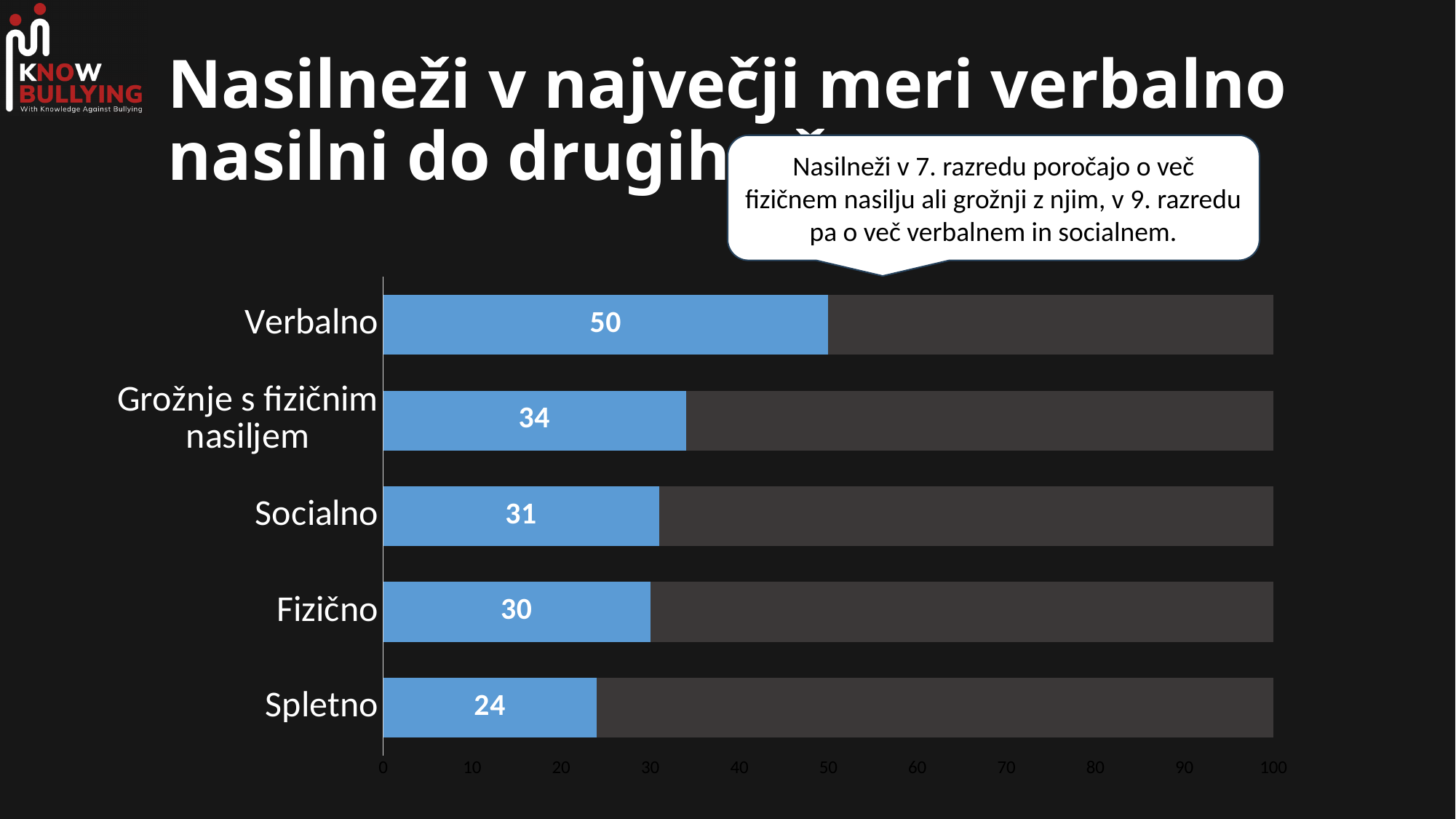
Which category has the lowest value? Spletno What is the value for Spletno? 24 Which is larger, the value for Socialno or the value for Fizično? Socialno How many categories are shown in the chart? 5 What is the difference between the values for Grožnje s fizičnim nasiljem and Fizično? 4 What is the value for Socialno? 31 What is the value for Grožnje s fizičnim nasiljem? 34 Is the value for Verbalno greater or less than 40? greater What kind of chart is shown on the slide? Bar chart What is the value for Verbalno? 50 Which category has the highest value? Verbalno What is the difference between the values for Verbalno and Spletno? 26